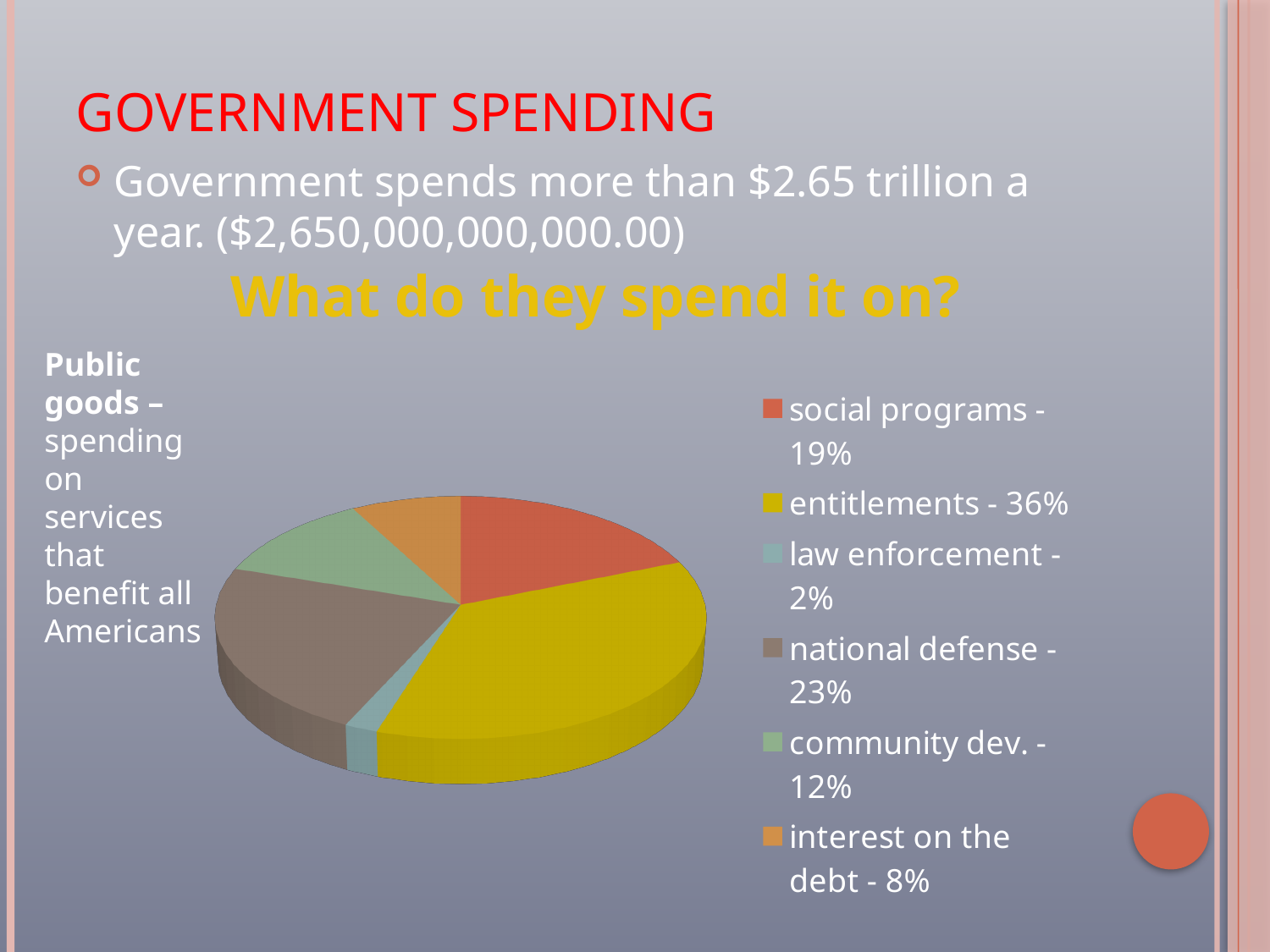
What percentage of government spending goes to interest on the debt? 8% How many categories does the pie chart show? 6 What percentage of government spending goes to entitlements? 36% What percentage of government spending goes to national defense? 23% What colour is the entitlements slice in the pie chart? yellow What percentage of government spending goes to law enforcement? 2% Which is larger, the share for social programs or the share for community dev.? social programs Which category has the largest share of government spending? entitlements Which category has the smallest share of government spending? law enforcement What is the difference in percentage points between entitlements and national defense? 13 What is the combined share of social programs and national defense? 42% What kind of chart is shown on the slide? pie chart